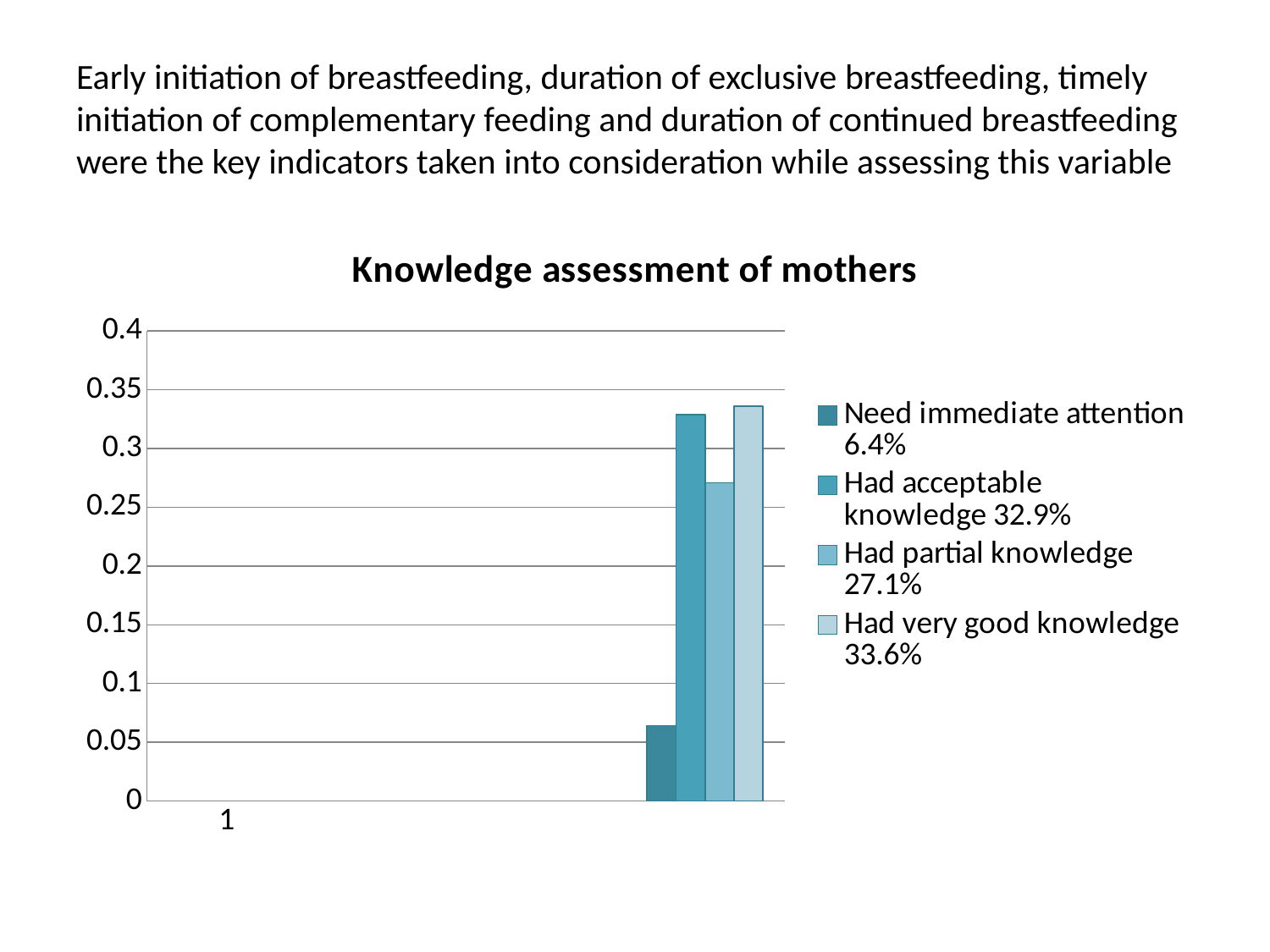
What type of chart is shown on the slide? bar chart Which series has the lowest value? Need immediate attention 6.4% What is the difference in percentage points between 'Had very good knowledge' and 'Had partial knowledge'? 6.5 What percentage does the legend give for 'Had acceptable knowledge'? 32.9% What percentage does the legend give for 'Had partial knowledge'? 27.1% How many series does the chart's legend list? 4 What percentage does the legend give for 'Had very good knowledge'? 33.6% Is the bar for 'Need immediate attention' greater or less than 0.1 on the y axis? less Which is larger, the value for 'Had acceptable knowledge' or the value for 'Had partial knowledge'? Had acceptable knowledge Which series has the highest value? Had very good knowledge 33.6% What percentage does the legend give for 'Need immediate attention'? 6.4% What is the title of the chart? Knowledge assessment of mothers